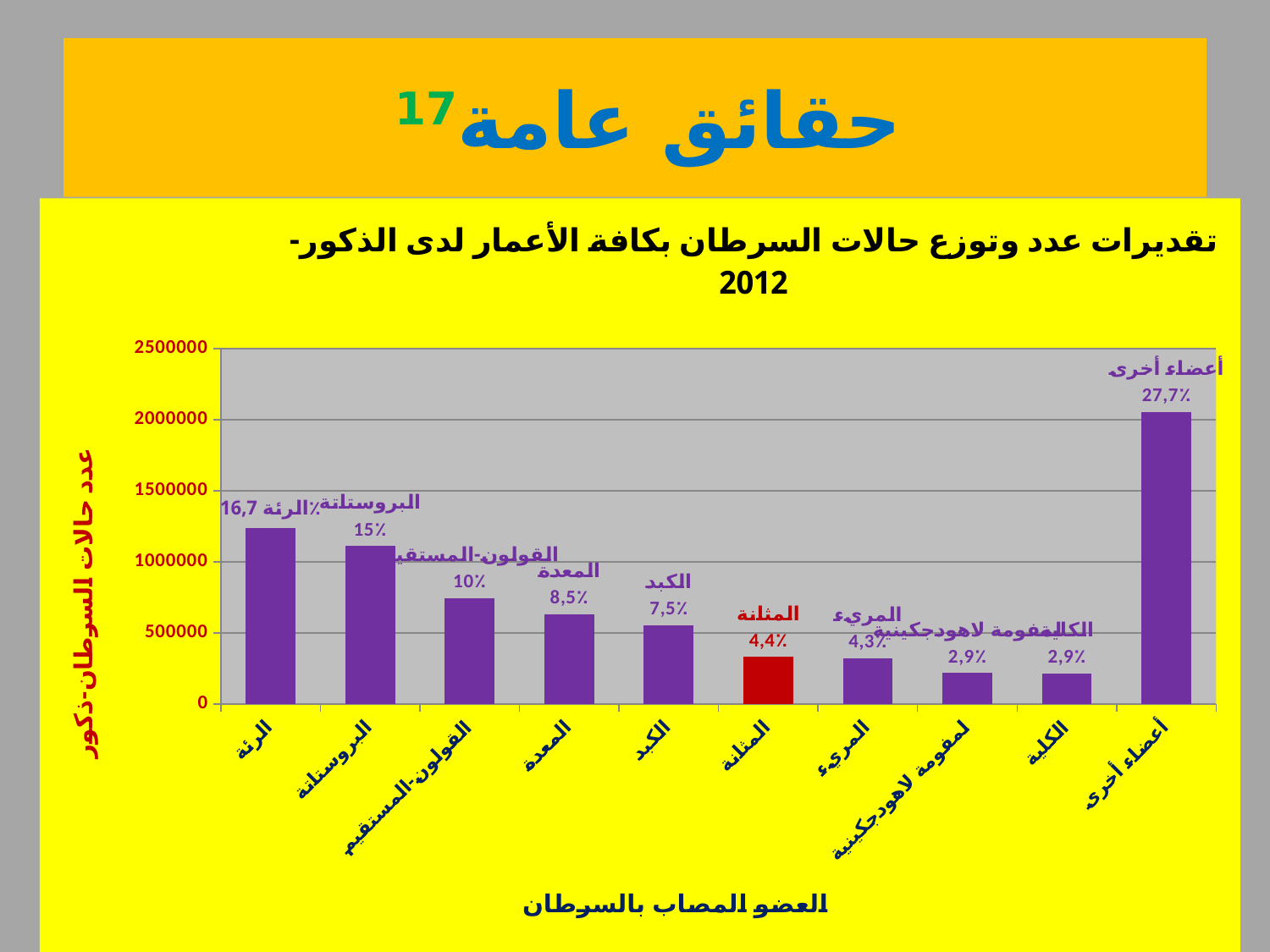
What percentage is shown for الرئة (lung)? 16,7% What percentage is shown for المثانة (bladder)? 4,4% Which category's bar is coloured red instead of purple? المثانة Which has a larger value, الكبد or المعدة? المعدة Is the value for أعضاء أخرى greater or less than 1500000? greater What percentage is shown for البروستاتة (prostate)? 15% Is the value for الكلية greater or less than 500000? less Which category has the highest value in the chart? أعضاء أخرى What kind of chart is shown on the slide? bar chart What is the difference in percentage between البروستاتة (15%) and القولون-المستقيم (10%)? 5% How many categories are shown on the x axis of the chart? 10 Is the value for الرئة greater or less than 1000000? greater